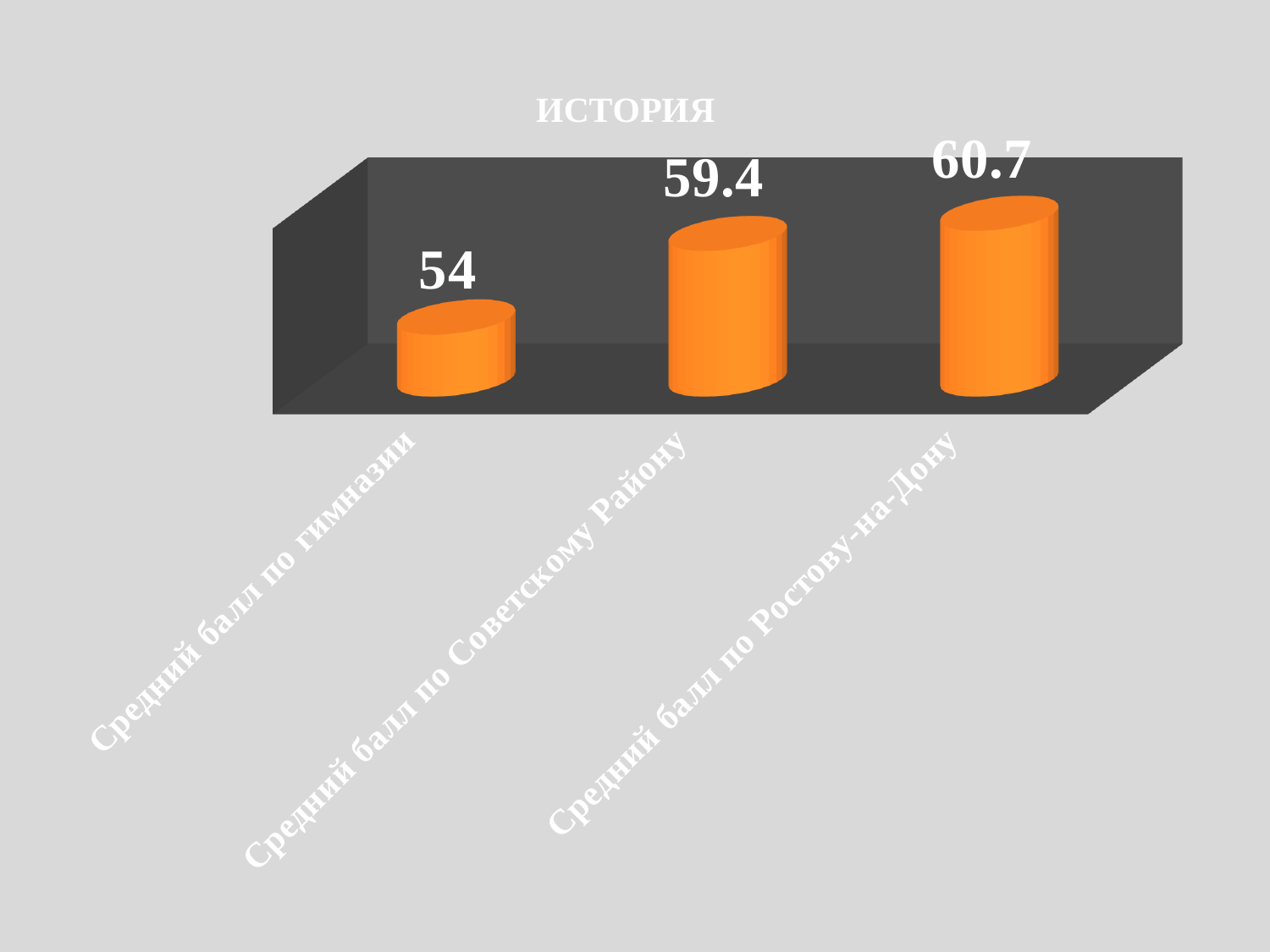
Which category has the highest value? Средний балл по Ростову-на-Дону Which category has the lowest value? Средний балл по гимназии Do the values rise or fall from left to right across the categories? rise What is the difference between the value for Средний балл по Ростову-на-Дону and the value for Средний балл по гимназии? 6.7 What is the title of the chart? ИСТОРИЯ Which is larger: the value for Средний балл по гимназии or the value for Средний балл по Советскому Району? Средний балл по Советскому Району What is the value for Средний балл по гимназии? 54 What kind of chart is this? bar chart What is the value for Средний балл по Ростову-на-Дону? 60.7 What is the difference between the value for Средний балл по Советскому Району and the value for Средний балл по гимназии? 5.4 What is the value for Средний балл по Советскому Району? 59.4 How many categories are shown in the chart? 3